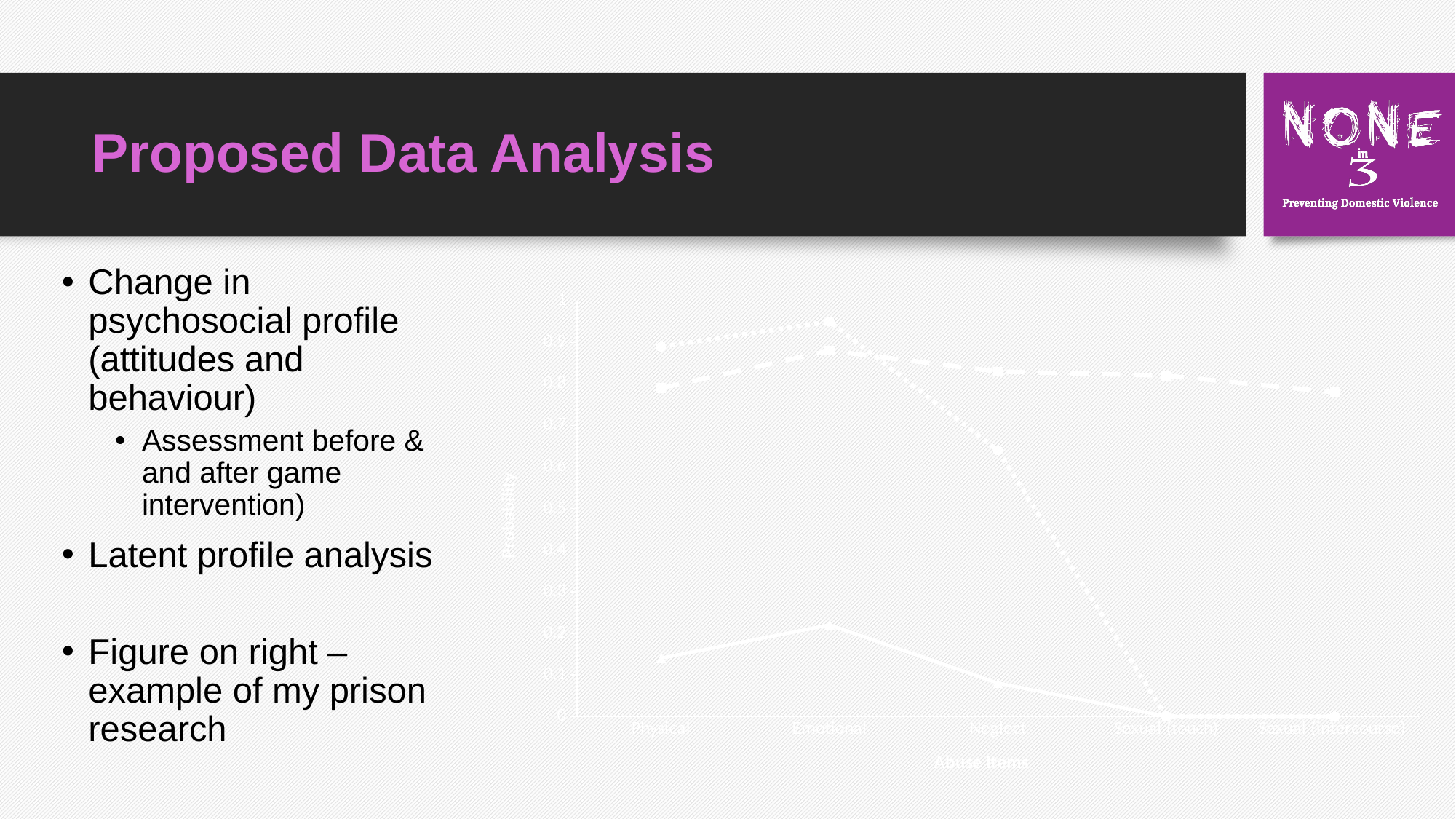
Is the value of the dashed line for Sexual (intercourse) greater or less than 0.5? greater Is the value of the dotted line for Sexual (touch) greater or less than 0.5? less For which category does the solid line reach its highest value? Emotional What is the title of the y axis of the chart? Probability Does the dotted line rise or fall from Emotional to Sexual (touch)? fall How many lines are plotted on the chart? 3 Is the value of the solid line for Emotional greater or less than 0.5? less How many categories are shown on the x axis of the chart? 5 What is the title of the x axis of the chart? Abuse Items At Neglect, which line has the larger value, the dashed line or the solid line? the dashed line What kind of chart is shown on the slide? line chart